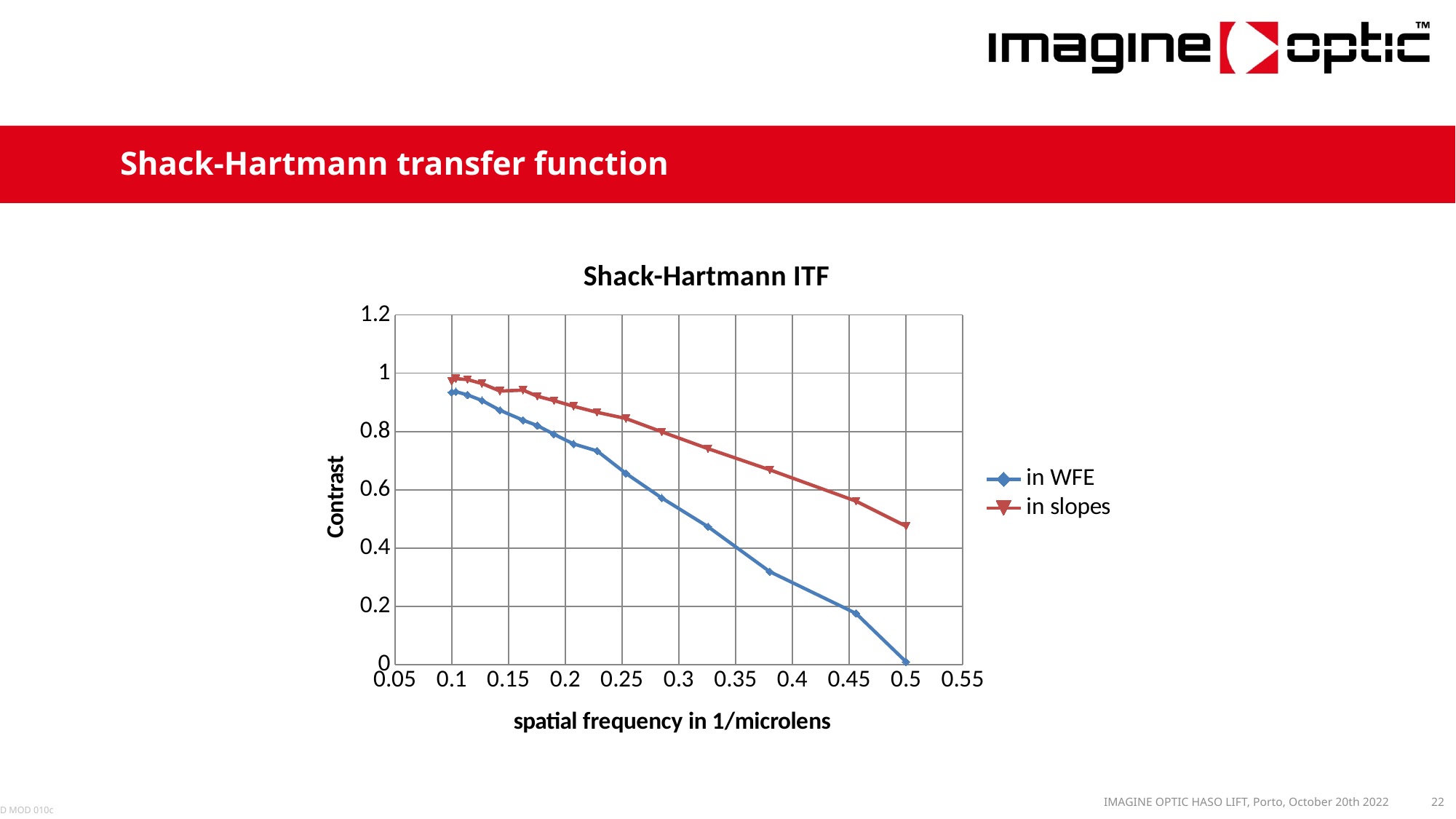
Is the contrast for 'in WFE' at a spatial frequency of 0.4 greater or less than 0.4? less At a spatial frequency of 0.5, which series has the higher contrast? in slopes What is the label of the x axis of the chart? spatial frequency in 1/microlens Is the contrast for 'in WFE' at a spatial frequency of 0.1 greater or less than 0.8? greater What kind of chart is shown on the slide? line chart Does the contrast for the 'in slopes' series rise or fall as spatial frequency increases? fall At a spatial frequency of 0.4, which series has the higher contrast, 'in WFE' or 'in slopes'? in slopes How many series does the legend of the Shack-Hartmann ITF chart list? 2 Is the contrast for 'in slopes' at a spatial frequency of 0.4 greater or less than 0.6? greater What is the title of the chart? Shack-Hartmann ITF Does the contrast for the 'in WFE' series rise or fall as spatial frequency increases? fall